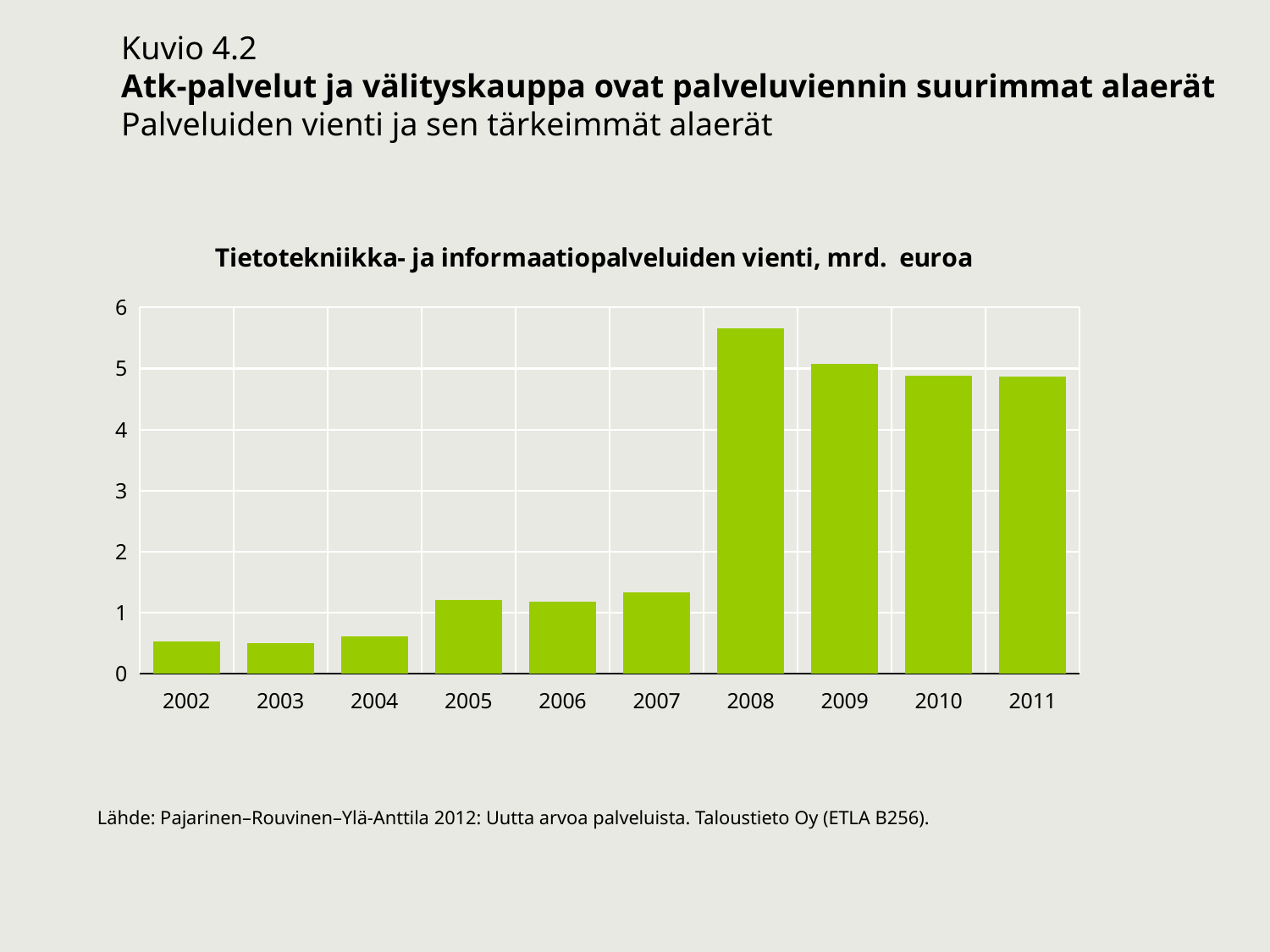
Which year has the highest value in the chart? 2008 What is the title of the chart? Tietotekniikka- ja informaatiopalveluiden vienti, mrd. euroa Is the value for 2008 greater or less than 5? greater Is the value for 2011 greater or less than 5? less How many years are shown on the x axis of the chart? 10 Is the value for 2005 greater or less than 1? greater Which year has the larger value, 2006 or 2007? 2007 Do the values generally rise or fall from 2002 to 2011? rise Which year has the larger value, 2008 or 2009? 2008 What kind of chart is shown on the slide? Bar chart